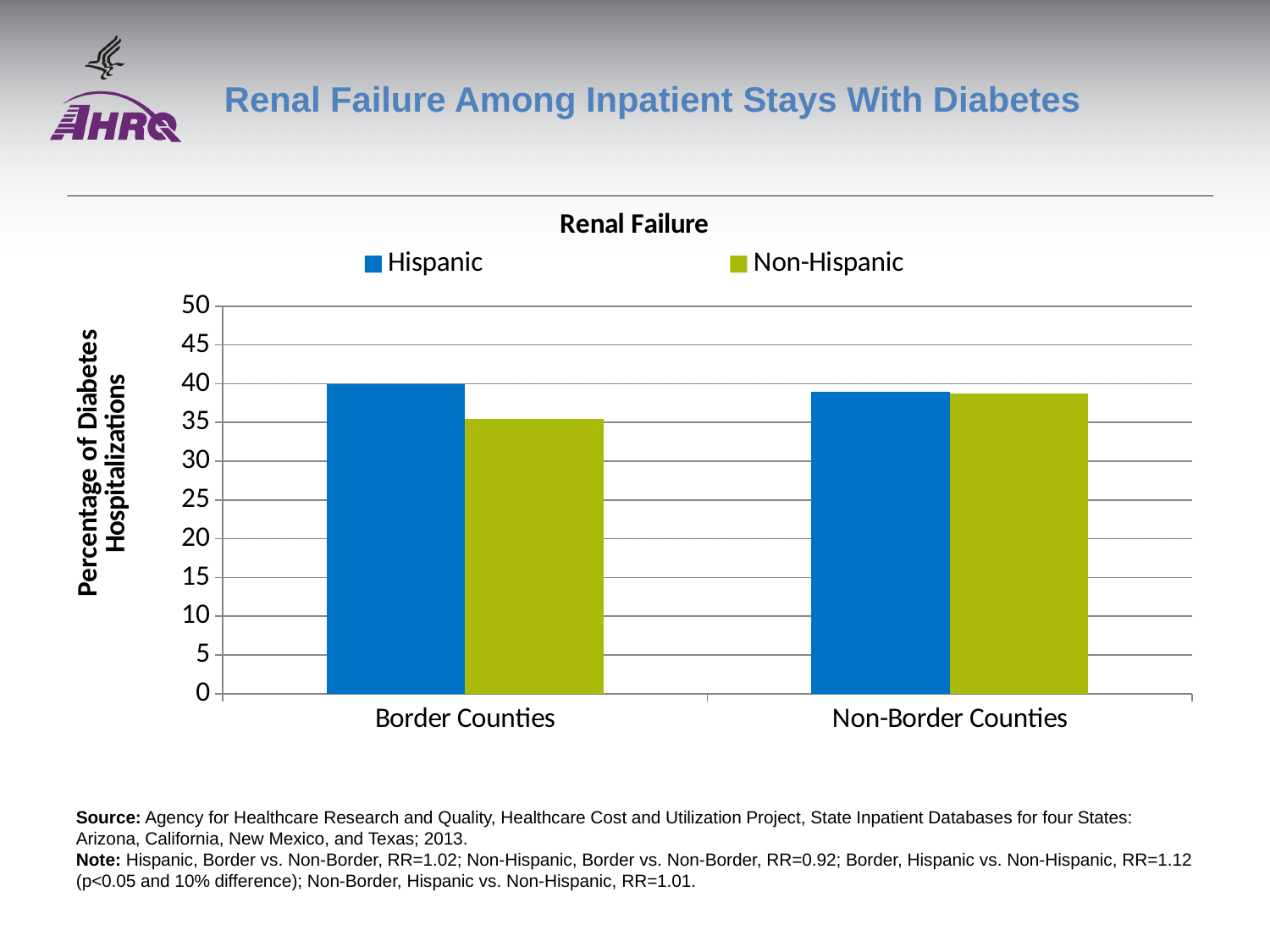
Is the Non-Hispanic value for Non-Border Counties greater or less than 30? greater In Border Counties, which is larger: the Hispanic value or the Non-Hispanic value? Hispanic How many series does the legend list? 2 What kind of chart is shown on the slide? Bar chart Is the Hispanic value for Non-Border Counties greater or less than 35? greater Is the Hispanic value for Border Counties greater or less than 35? greater Which series has the lowest bar in the chart? Non-Hispanic, Border Counties What is the title of the chart? Renal Failure How many categories are shown on the x axis? 2 What is the label on the y axis of the chart? Percentage of Diabetes Hospitalizations